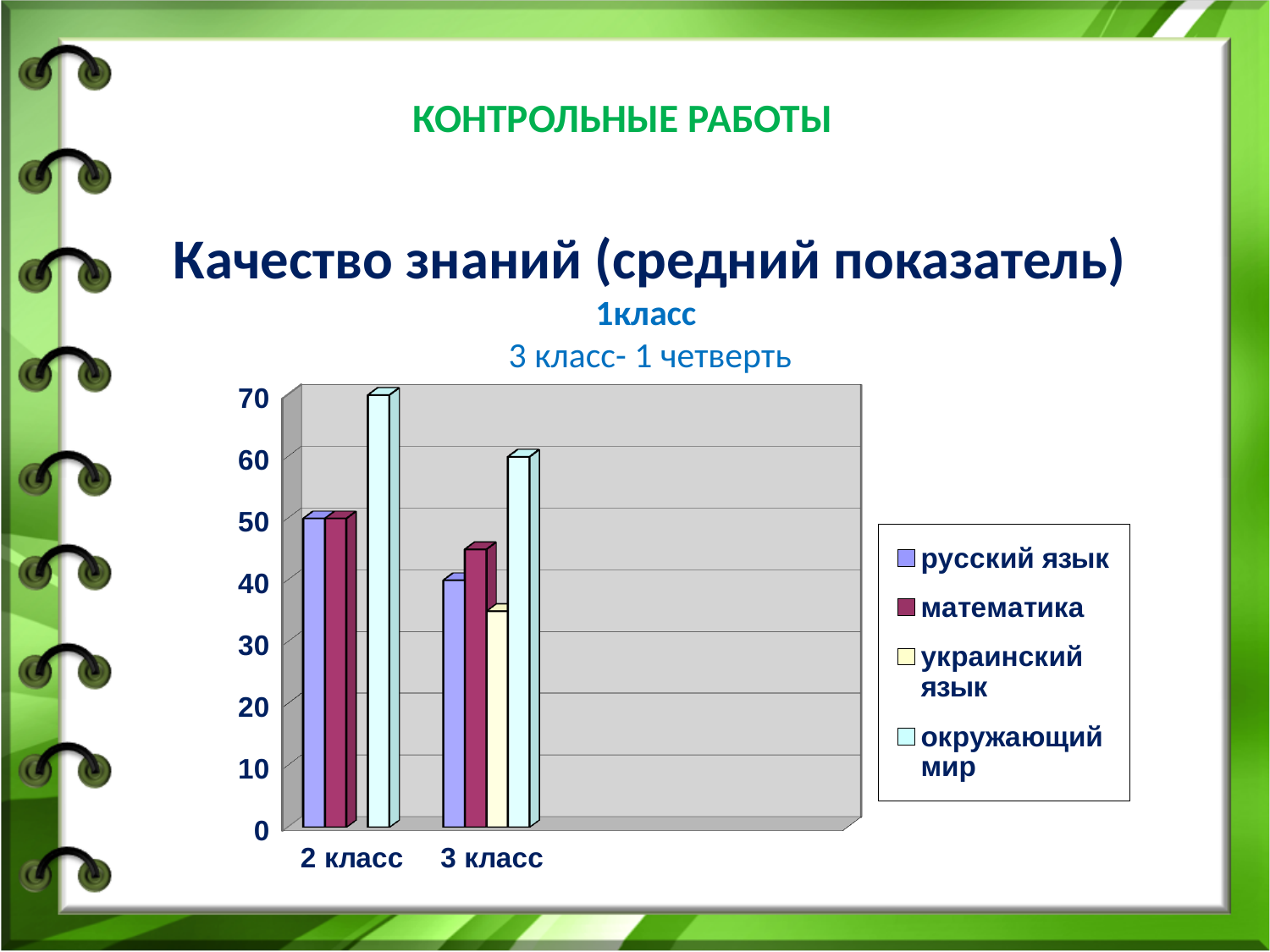
How many series does the legend list? 4 Is the value for окружающий мир in 2 класс greater or less than 60? greater Which subject has the lowest value for 3 класс? украинский язык What is the subtitle shown directly above the chart? 3 класс- 1 четверть Does the value for русский язык rise or fall from 2 класс to 3 класс? fall Is the value for математика in 3 класс greater or less than 40? greater Is the value for украинский язык in 3 класс greater or less than 40? less How many categories are shown on the x axis? 2 Which is larger: окружающий мир for 2 класс or окружающий мир for 3 класс? 2 класс What kind of chart is shown on the slide? bar chart Which subject has the highest value for 2 класс? окружающий мир